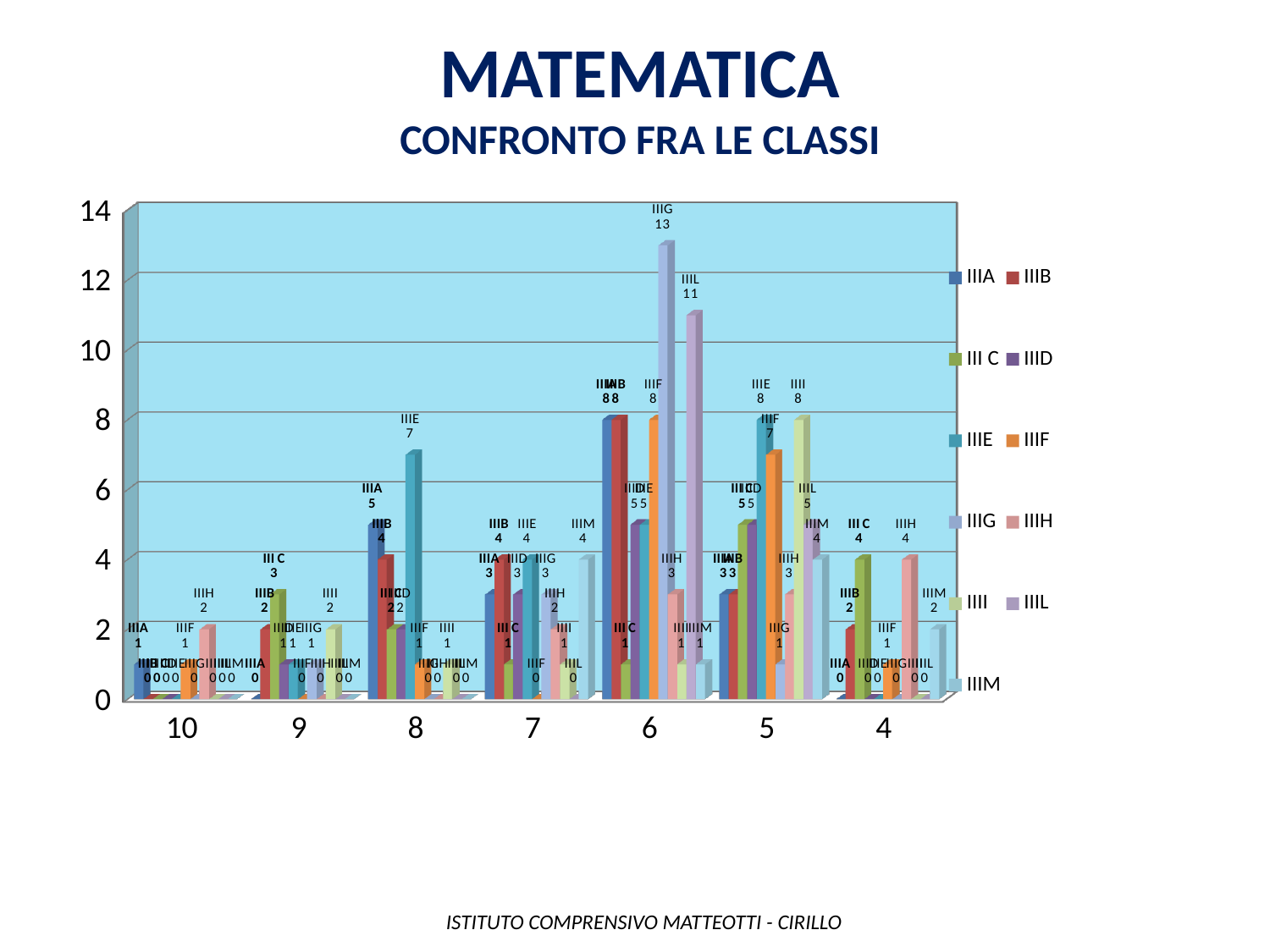
What is the value for IIIL at grade 6? 11 What type of chart is shown on the slide? bar chart What is the value for IIIH at grade 10? 2 What is the value for IIIG at grade 6? 13 How many grade categories are shown on the x axis? 7 How many series does the legend list? 11 What is the value for III C at grade 9? 3 What is the difference between the IIIG value and the IIIL value at grade 6? 2 Which series has the highest bar in the whole chart? IIIG What is the value for IIIE at grade 8? 7 What is the subtitle of the chart below MATEMATICA? CONFRONTO FRA LE CLASSI Which is larger at grade 5: the value for IIIE or the value for IIIF? IIIE